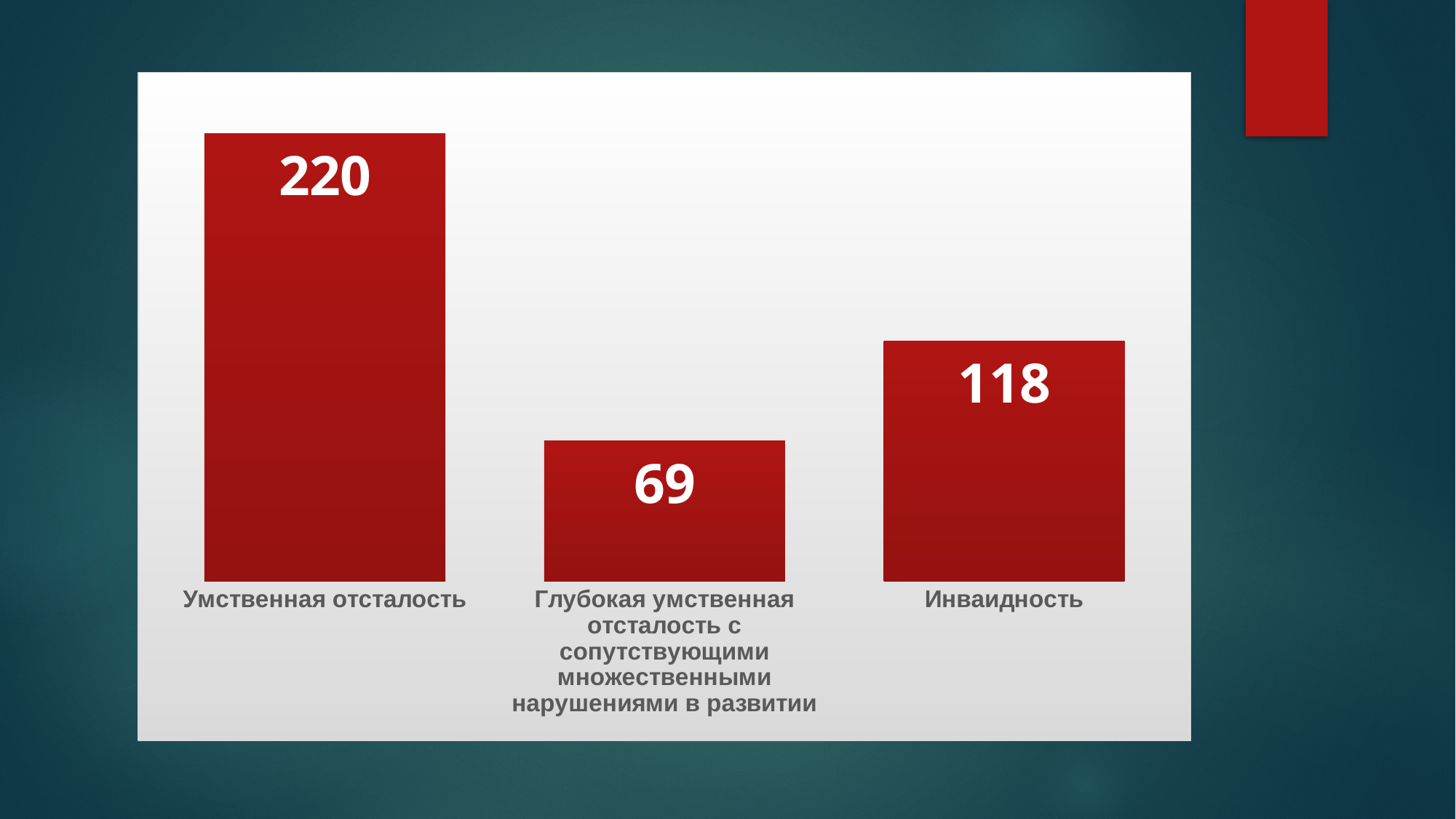
What is the value for Умственная отсталость? 220 What is the difference between the values for Умственная отсталость and Инваидность? 102 What kind of chart is shown on the slide? bar chart How many categories are shown in the chart? 3 What is the total of all three values shown in the chart? 407 What is the value for Глубокая умственная отсталость с сопутствующими множественными нарушениями в развитии? 69 What is the value for Инваидность? 118 Which is larger, the value for Инваидность or the value for Глубокая умственная отсталость с сопутствующими множественными нарушениями в развитии? Инваидность What colour are the bars in the chart? red Which category has the lowest value? Глубокая умственная отсталость с сопутствующими множественными нарушениями в развитии Which category has the highest value? Умственная отсталость What is the difference between the values for Инваидность and Глубокая умственная отсталость с сопутствующими множественными нарушениями в развитии? 49